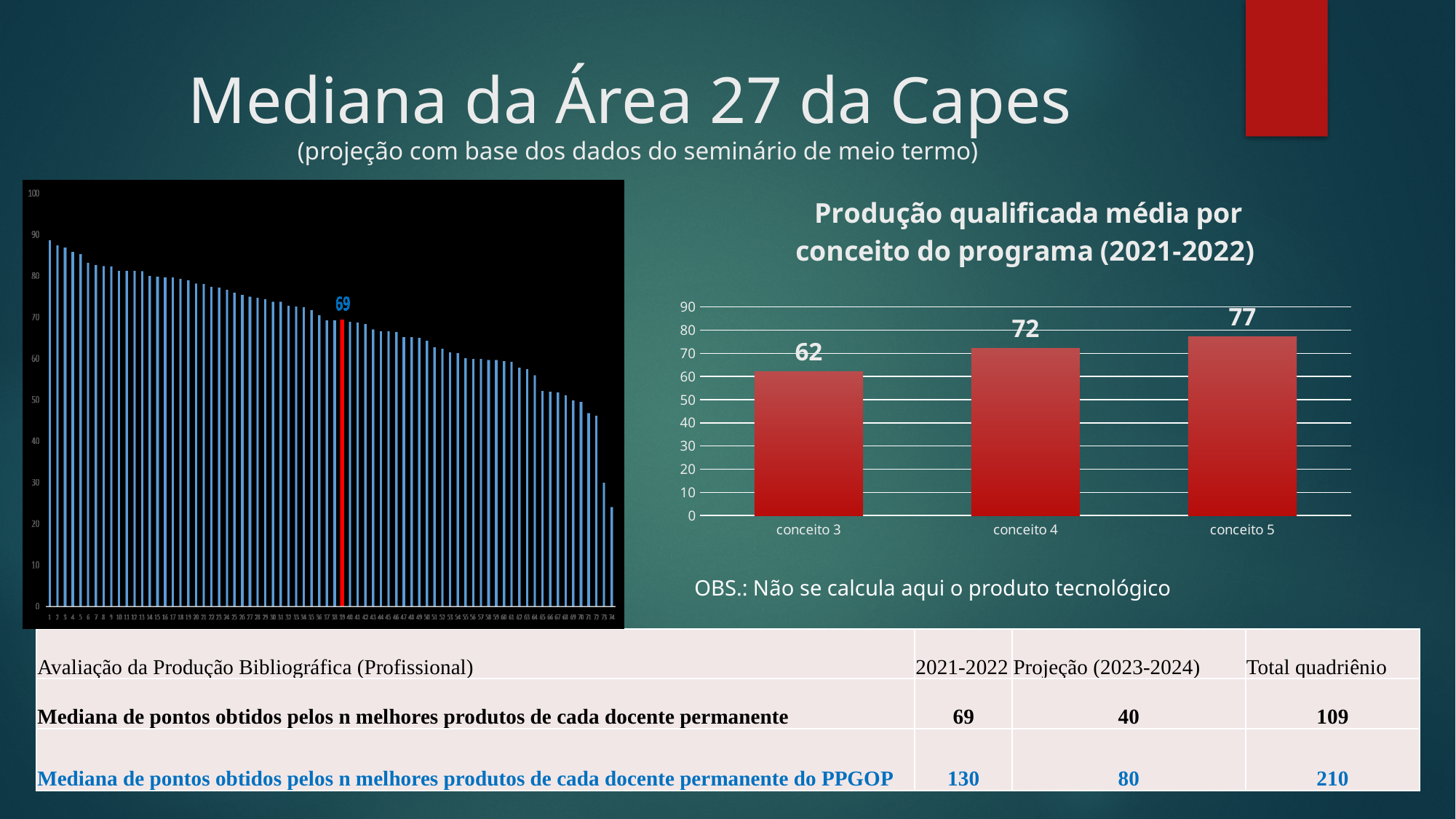
In the chart titled 'Produção qualificada média por conceito do programa (2021-2022)', how many categories are shown? 3 In the chart titled 'Produção qualificada média por conceito do programa (2021-2022)', which is larger, the value for conceito 4 or conceito 3? conceito 4 In the chart titled 'Produção qualificada média por conceito do programa (2021-2022)', which category has the lowest value? conceito 3 In the chart titled 'Produção qualificada média por conceito do programa (2021-2022)', what is the difference between the values for conceito 5 and conceito 3? 15 In the chart titled 'Produção qualificada média por conceito do programa (2021-2022)', do the values rise or fall from conceito 3 to conceito 5? rise In the chart titled 'Produção qualificada média por conceito do programa (2021-2022)', which category has the highest value? conceito 5 In the chart titled 'Produção qualificada média por conceito do programa (2021-2022)', what is the value for conceito 4? 72 In the bar chart on the left of the slide with the black background, what value is labelled on the red highlighted bar? 69 In the bar chart on the left of the slide with the black background, is the value of the first bar greater or less than 80? greater What kind of chart is the one on the left of the slide with the black background? bar chart In the chart titled 'Produção qualificada média por conceito do programa (2021-2022)', what is the value for conceito 3? 62 In the chart titled 'Produção qualificada média por conceito do programa (2021-2022)', what is the value for conceito 5? 77